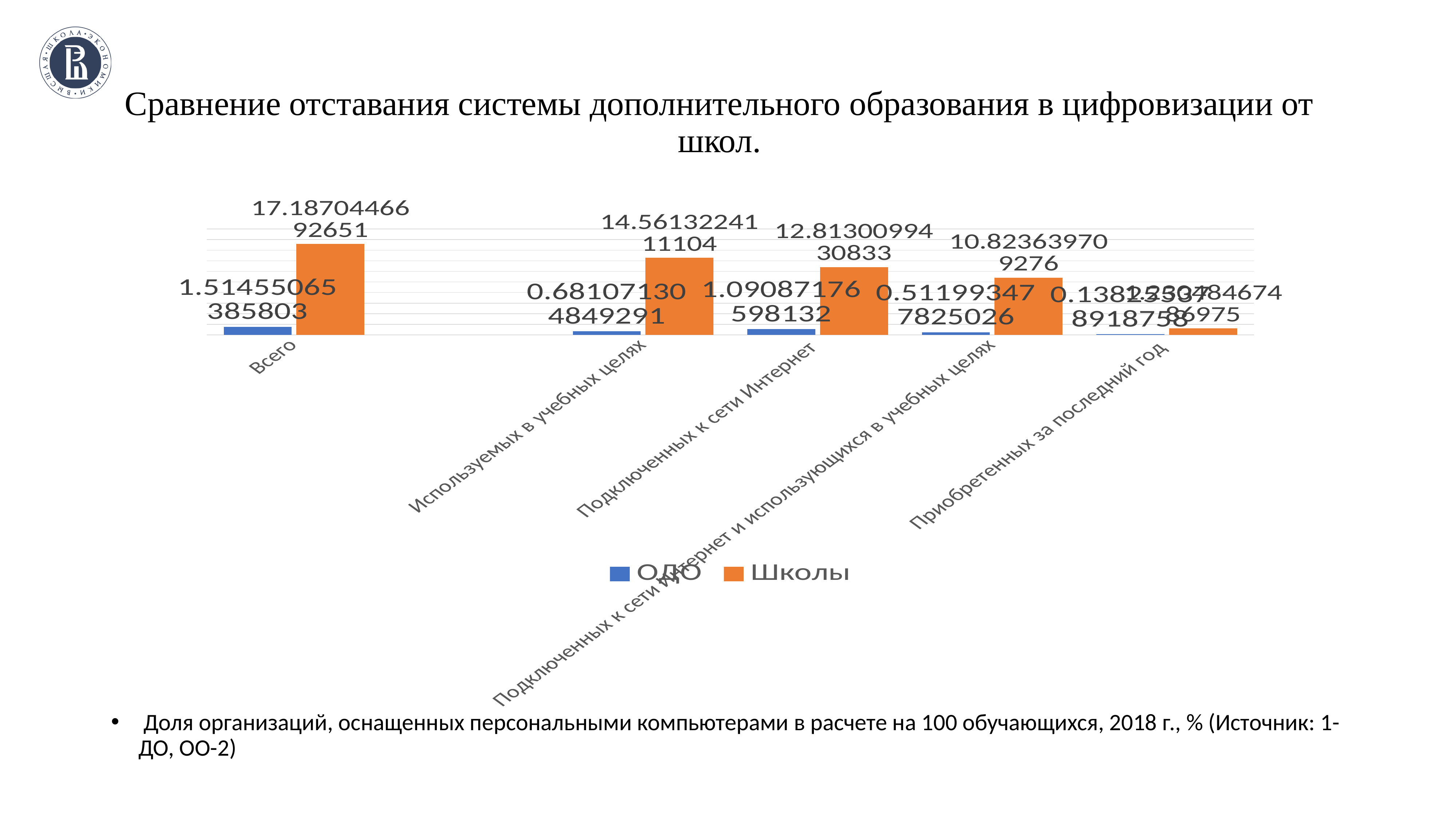
What kind of chart is shown on the slide? bar chart Which colour represents the Школы series in the chart? orange How many categories are shown on the x axis of the chart? 5 Which category has the highest value for the Школы series? Всего In the Подключенных к сети Интернет category, which series has the larger value, ОДО or Школы? Школы How many series does the chart legend list? 2 What are the two series named in the chart legend? ОДО and Школы What is the value for ОДО in the Всего category? 1.51455065385803 What is the value for Школы in the Используемых в учебных целях category? 14.5613224111104 Which category has the lowest value for the Школы series? Приобретенных за последний год What is the value for Школы in the Всего category? 17.1870446692651 What is the value for Школы in the Подключенных к сети Интернет category? 12.8130099430833